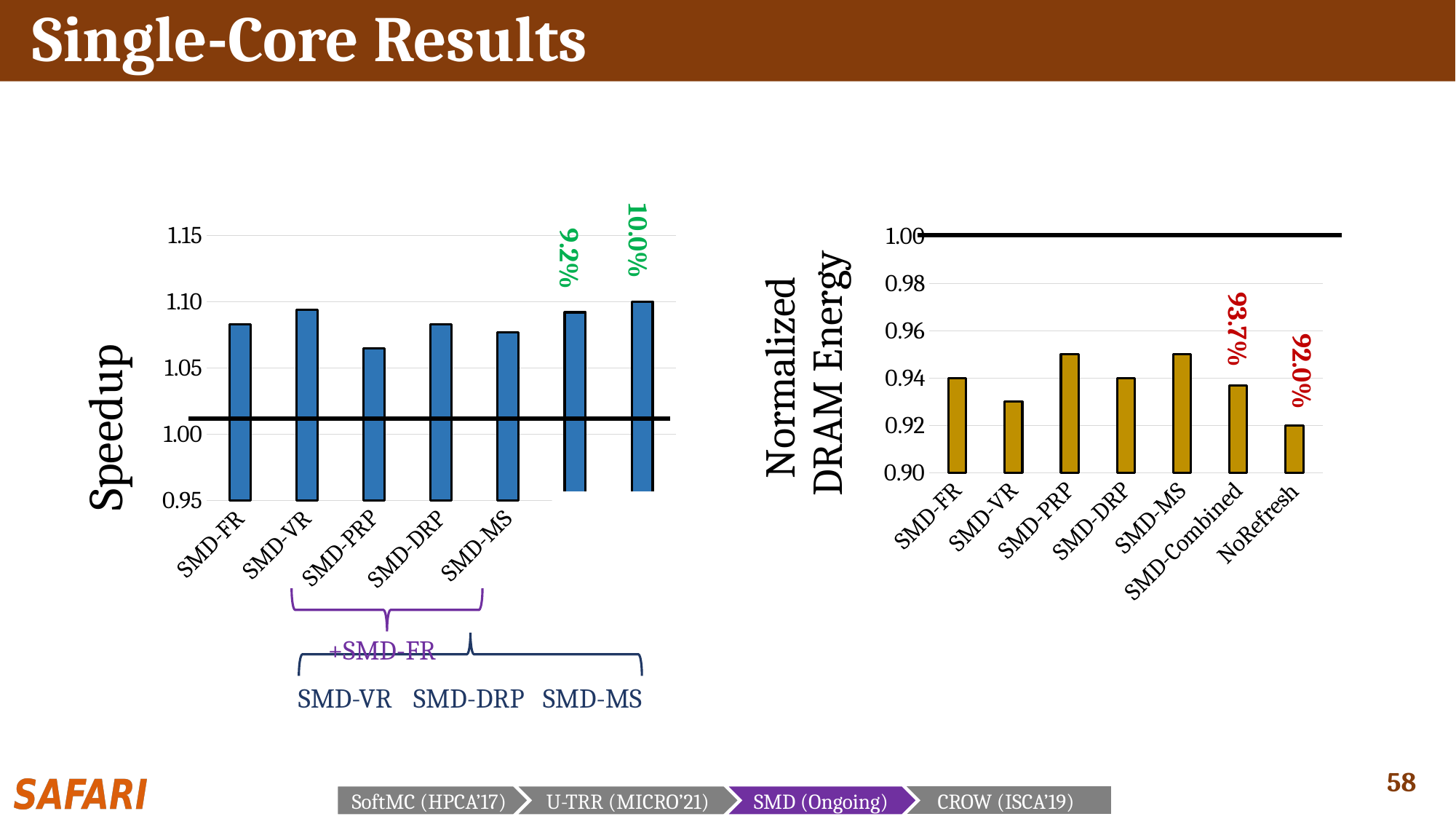
In the Normalized DRAM Energy chart on the right, what is the value for SMD-FR? 0.94 In the Speedup chart on the left, what are the two percentage labels printed above the rightmost two bars? 9.2% and 10.0% In the Normalized DRAM Energy chart on the right, is the value for SMD-VR greater or less than 0.94? less What is the y-axis title of the chart on the right? Normalized DRAM Energy In the Normalized DRAM Energy chart on the right, which is larger, SMD-VR or SMD-PRP? SMD-PRP In the Speedup chart on the left, which labeled category has the lowest speedup? SMD-PRP In the Normalized DRAM Energy chart on the right, how many categories are shown on the x axis? 7 In the Speedup chart on the left, is the value for SMD-VR greater or less than 1.05? greater In the Normalized DRAM Energy chart on the right, what is the value for NoRefresh? 0.92 In the Normalized DRAM Energy chart on the right, which category has the lowest value? NoRefresh What kind of chart is the Speedup chart on the left? bar chart In the Normalized DRAM Energy chart on the right, what percentage label is printed above the SMD-Combined bar? 93.7%